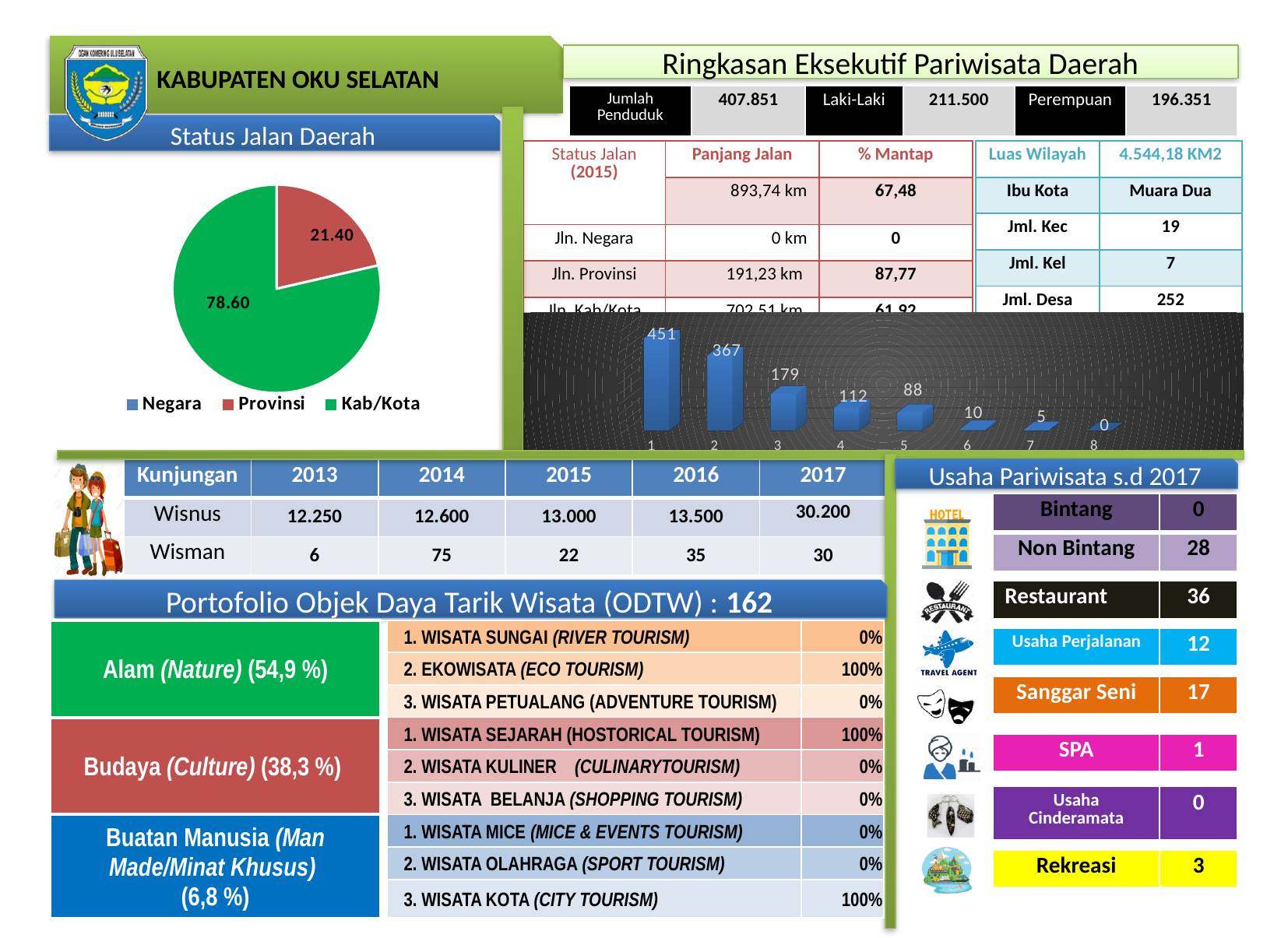
In the pie chart under 'Status Jalan Daerah', which category has the largest slice? Kab/Kota In the bar chart on the dark background in the middle right of the slide, which category has the highest value? 1 In the bar chart on the dark background in the middle right of the slide, do the values rise or fall from category 1 to category 8? Fall In the pie chart under 'Status Jalan Daerah', what is the value shown for the Kab/Kota slice? 78.60 In the bar chart on the dark background in the middle right of the slide, what is the value for category 3? 179 In the pie chart under 'Status Jalan Daerah', what is the value shown for the Provinsi slice? 21.40 What type of chart is shown under the heading 'Status Jalan Daerah'? Pie chart In the pie chart under 'Status Jalan Daerah', what colour is the Kab/Kota slice? Green In the bar chart on the dark background in the middle right of the slide, what is the value for category 1? 451 In the bar chart on the dark background in the middle right of the slide, how many categories are plotted? 8 In the bar chart on the dark background in the middle right of the slide, what is the difference between the values for category 1 and category 2? 84 How many entries does the legend of the pie chart under 'Status Jalan Daerah' list? 3